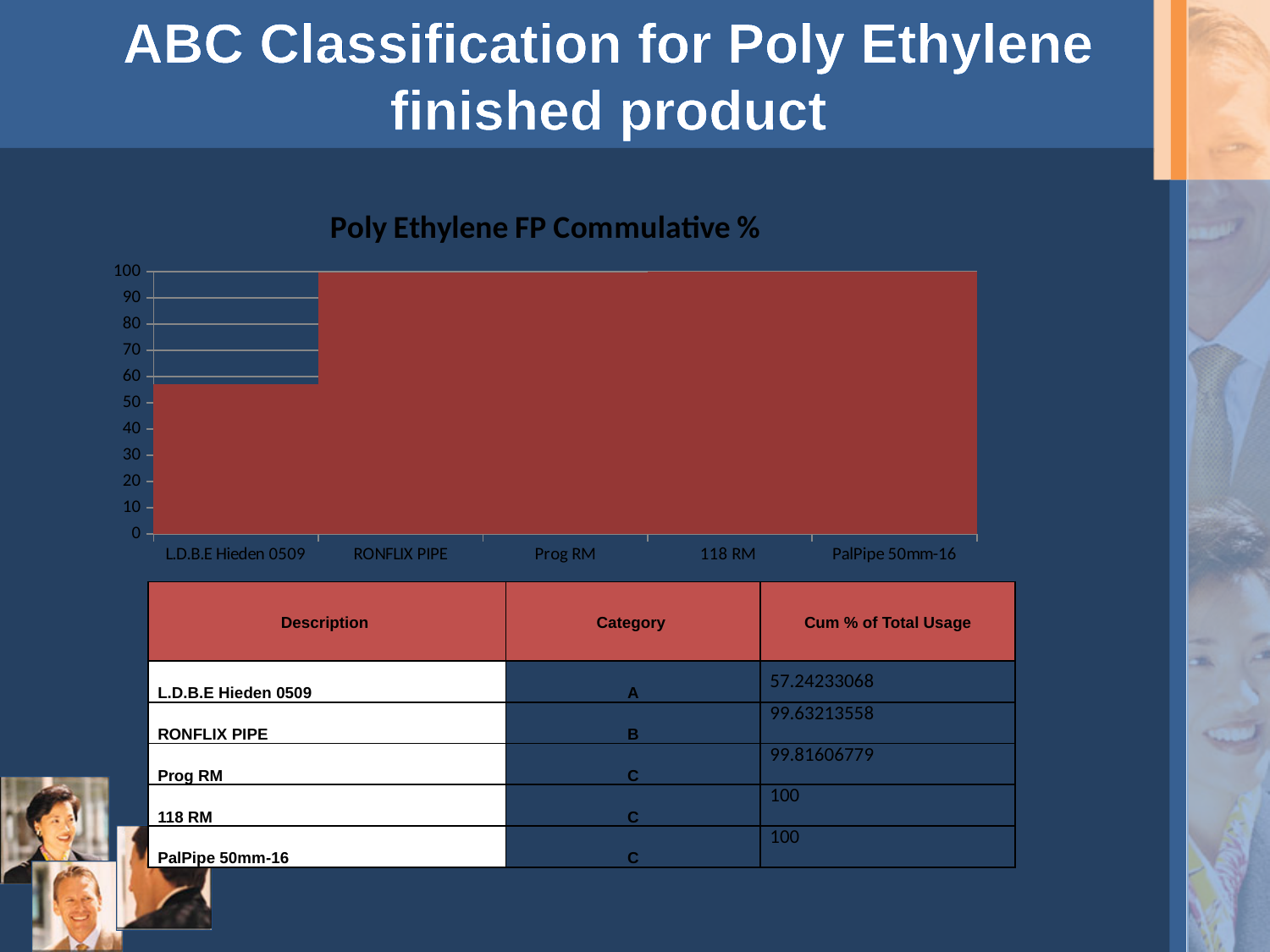
Do the values rise or fall from left to right along the x axis? rise Is the value for L.D.B.E Hieden 0509 greater or less than 50? greater What is the title of the chart? Poly Ethylene FP Commulative % Is the value for RONFLIX PIPE greater or less than 90? greater How many categories are shown on the x axis of the chart? 5 What is the first category label on the x axis of the chart? L.D.B.E Hieden 0509 Which is larger, the value for L.D.B.E Hieden 0509 or the value for Prog RM? Prog RM What kind of chart is shown on the slide? bar chart Is the value for L.D.B.E Hieden 0509 greater or less than 60? less What value does the bar for 118 RM reach on the y axis? 100 What value does the bar for PalPipe 50mm-16 reach on the y axis? 100 Which category has the lowest value in the chart? L.D.B.E Hieden 0509